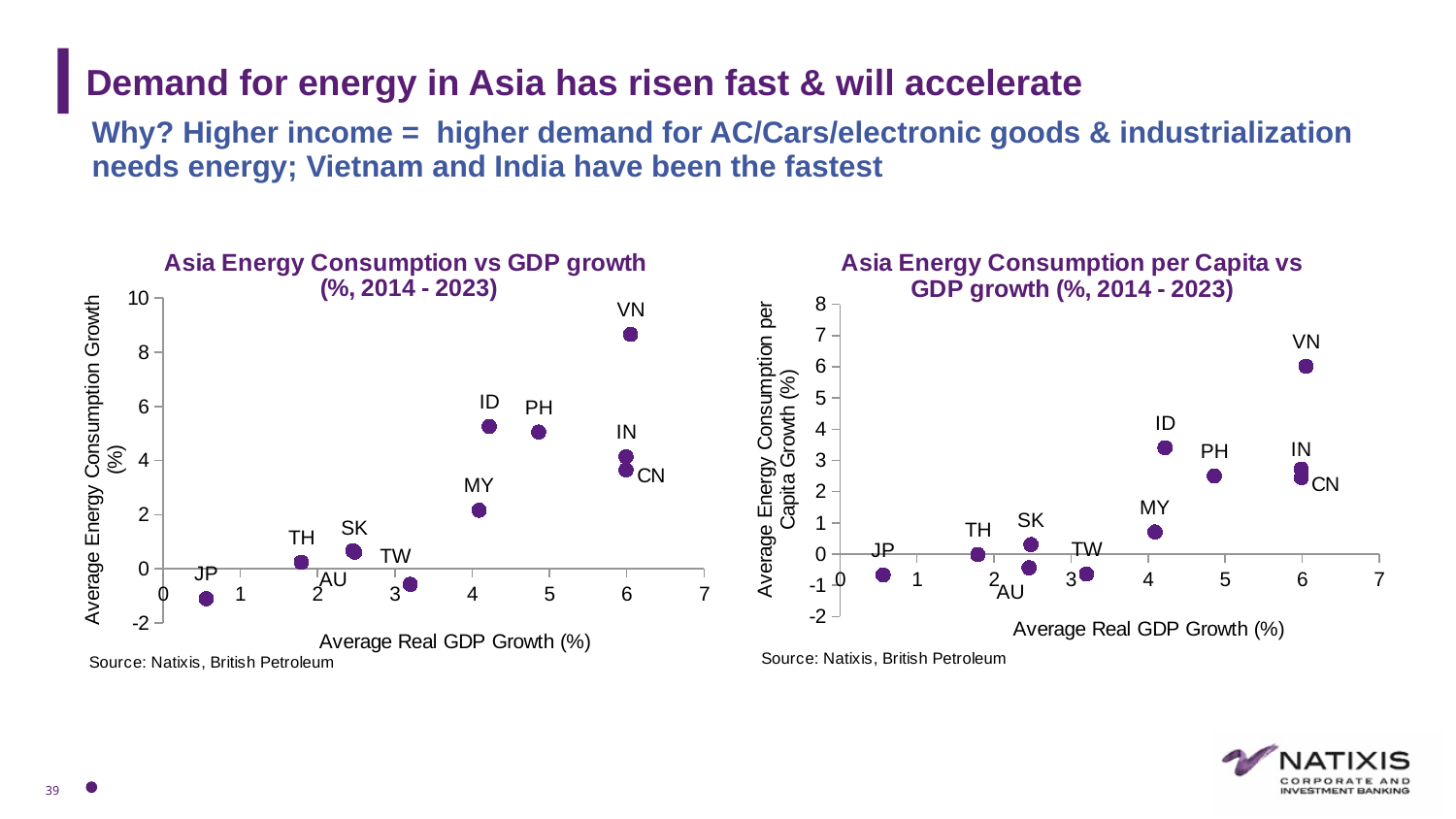
What kind of chart is the 'Asia Energy Consumption vs GDP growth' chart on the left? scatter chart In the 'Asia Energy Consumption per Capita vs GDP growth' chart, which country has the highest average energy consumption per capita growth? VN In the 'Asia Energy Consumption vs GDP growth' chart, is the average energy consumption growth for VN greater or less than 8? greater In the 'Asia Energy Consumption vs GDP growth' chart, how many countries are plotted? 11 In the 'Asia Energy Consumption vs GDP growth' chart, which country has the highest average energy consumption growth? VN In the 'Asia Energy Consumption vs GDP growth' chart, which has the higher average energy consumption growth, ID or MY? ID In the 'Asia Energy Consumption per Capita vs GDP growth' chart, how many countries are plotted? 11 In the 'Asia Energy Consumption vs GDP growth' chart, which country has the lowest average energy consumption growth? JP In the 'Asia Energy Consumption per Capita vs GDP growth' chart, which has the higher average energy consumption per capita growth, ID or PH? ID In the 'Asia Energy Consumption per Capita vs GDP growth' chart, is the value for ID greater or less than 3? greater In the 'Asia Energy Consumption vs GDP growth' chart, is the average energy consumption growth for JP greater or less than 0? less What is the x-axis title of the 'Asia Energy Consumption per Capita vs GDP growth' chart? Average Real GDP Growth (%)